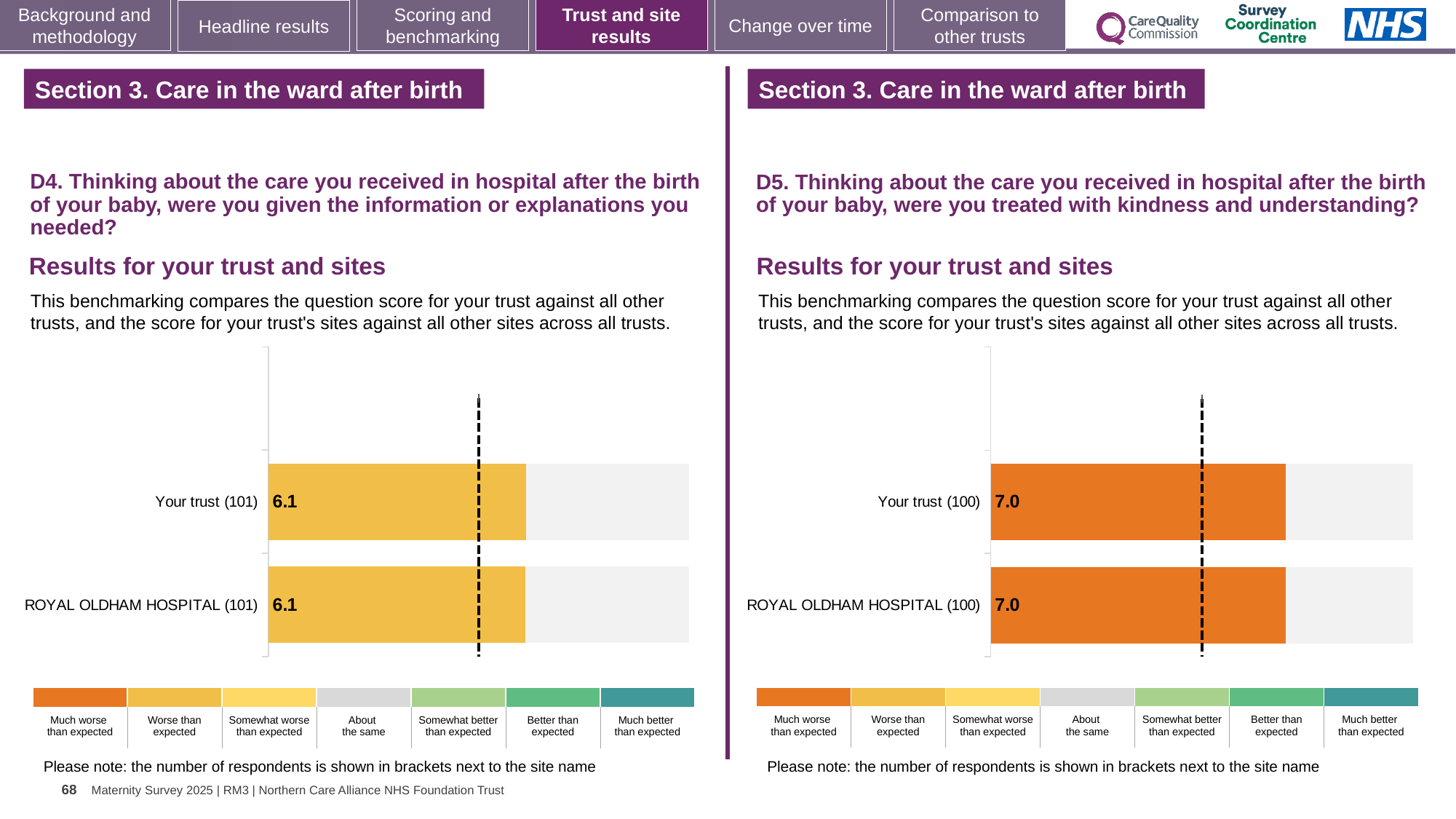
How many benchmark categories does the colour key below the D5 chart on the right list? 7 In the D4 chart on the left, what is the score for ROYAL OLDHAM HOSPITAL? 6.1 In the D4 chart on the left, how many respondents are shown in brackets next to Your trust? 101 In the D4 chart on the left, what is the difference between the score for Your trust and the score for ROYAL OLDHAM HOSPITAL? 0.0 What type of chart is used for the D4 results on the left? Bar chart In the D5 chart on the right, how many respondents are shown in brackets next to ROYAL OLDHAM HOSPITAL? 100 In the D4 chart on the left, what is the score for Your trust? 6.1 In the D5 chart on the right, what is the score for Your trust? 7.0 How many bars are plotted in the D5 chart on the right? 2 In the D5 chart on the right, what is the score for ROYAL OLDHAM HOSPITAL? 7.0 In the D5 chart on the right, what is the difference between the score for Your trust and the score for ROYAL OLDHAM HOSPITAL? 0.0 How many bars are plotted in the D4 chart on the left? 2